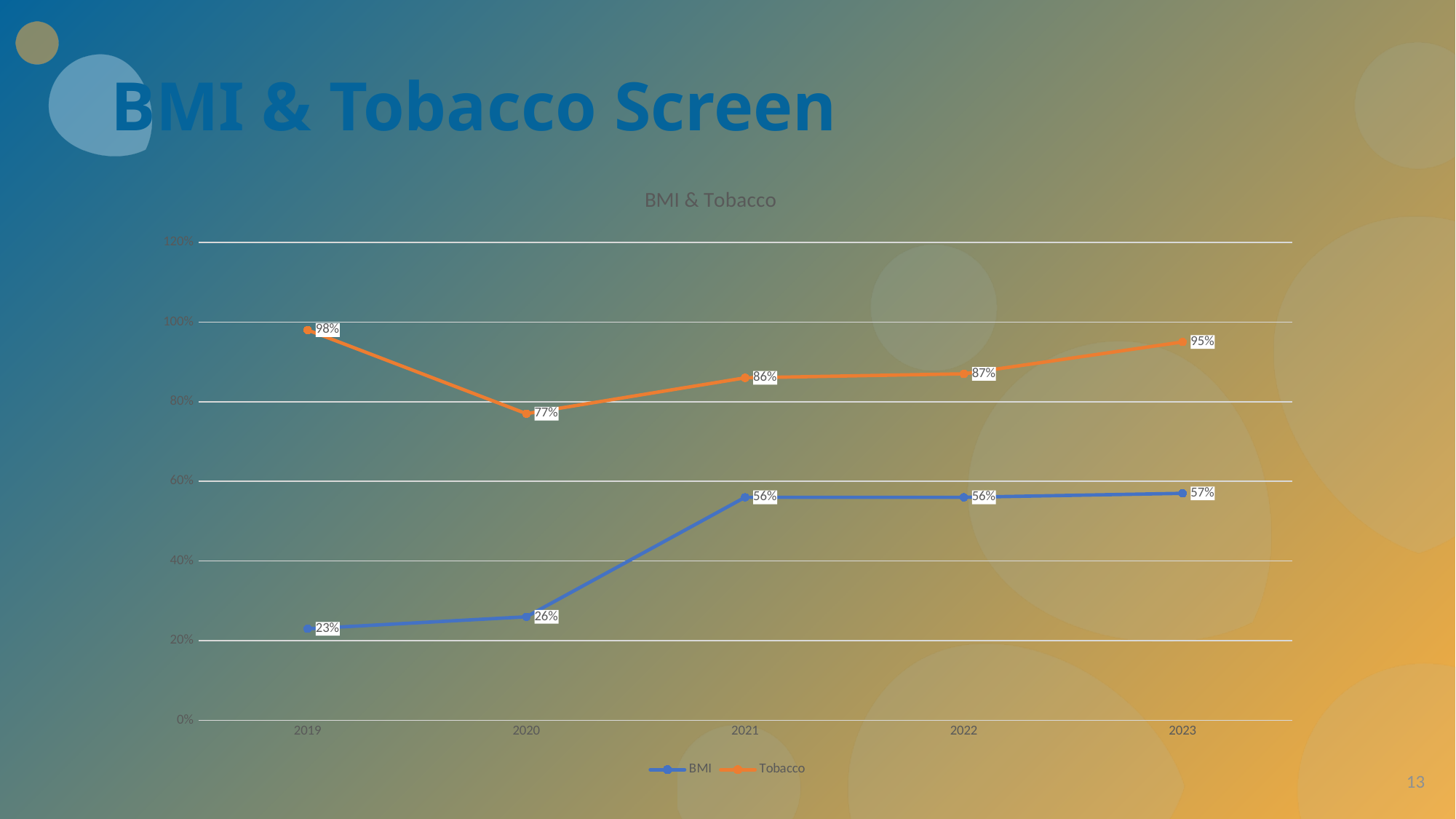
What is the BMI value for 2019? 23% How many series does the legend list? 2 How many years are shown on the x axis? 5 What is the difference between the Tobacco and BMI values in 2021? 30% Does the BMI value rise or fall from 2019 to 2021? Rise What is the title of the chart? BMI & Tobacco What kind of chart is shown on the slide? Line chart Which is larger in 2022, the BMI value or the Tobacco value? Tobacco What is the BMI value for 2023? 57% What is the Tobacco value for 2020? 77% In which year is the Tobacco value highest? 2019 In which year is the BMI value lowest? 2019